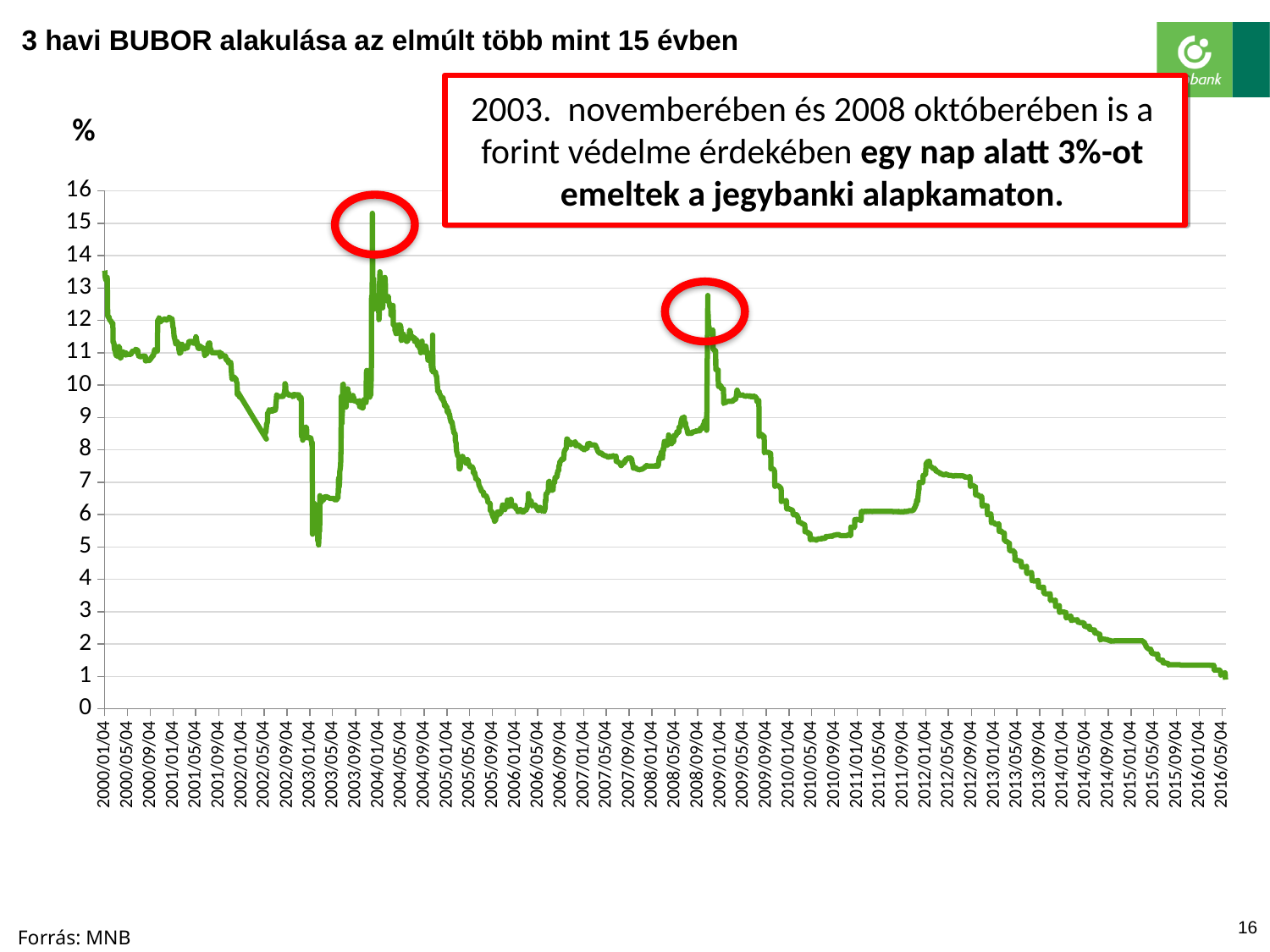
What is the title of the chart on the slide? 3 havi BUBOR alakulása az elmúlt több mint 15 évben In which year does the 3-month BUBOR reach its lowest value on the chart? 2016 In which year does the 3-month BUBOR reach its highest value on the chart? 2003 Is the value at 2012/05/04 greater or less than 7? greater Is the value at 2010/05/04 greater or less than 6? less Is the value at 2000/01/04 greater or less than 12? greater Which is larger: the value at 2000/01/04 or the value at 2016/05/04? 2000/01/04 Which is higher: the spike in late 2003 or the spike in late 2008? the spike in late 2003 What kind of chart is shown on the slide? line chart Overall, does the 3-month BUBOR rise or fall from 2000 to 2016 along the x axis? fall What unit is shown on the vertical axis of the chart? %